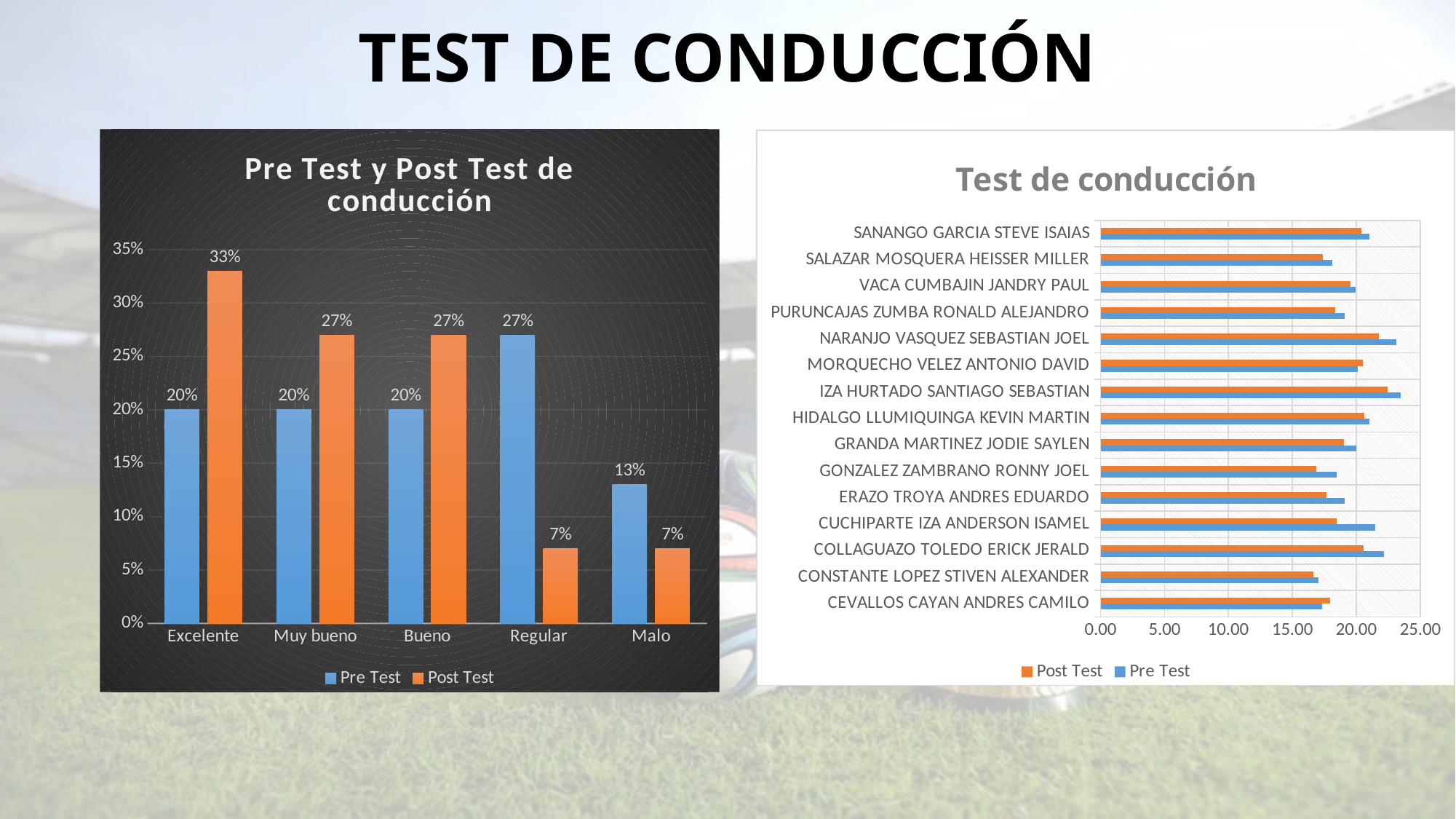
In the chart titled 'Pre Test y Post Test de conducción', which category has the lowest Pre Test value? Malo In the chart titled 'Test de conducción', is the Pre Test value for NARANJO VASQUEZ SEBASTIAN JOEL greater or less than 20.00? greater In the chart titled 'Test de conducción', is the Post Test value for CONSTANTE LOPEZ STIVEN ALEXANDER greater or less than 20.00? less What kind of chart is the chart titled 'Test de conducción'? Bar chart In the chart titled 'Pre Test y Post Test de conducción', what is the Post Test value for Excelente? 33% How many series does the legend of the chart titled 'Test de conducción' list? 2 In the chart titled 'Pre Test y Post Test de conducción', which category has the highest Post Test value? Excelente How many categories are shown on the x axis of the chart titled 'Pre Test y Post Test de conducción'? 5 In the chart titled 'Pre Test y Post Test de conducción', which is larger for Regular: the Pre Test value or the Post Test value? Pre Test In the chart titled 'Pre Test y Post Test de conducción', what is the Pre Test value for Regular? 27% In the chart titled 'Pre Test y Post Test de conducción', what is the Pre Test value for Malo? 13% In the chart titled 'Pre Test y Post Test de conducción', what is the difference between the Post Test and Pre Test values for Excelente? 13%